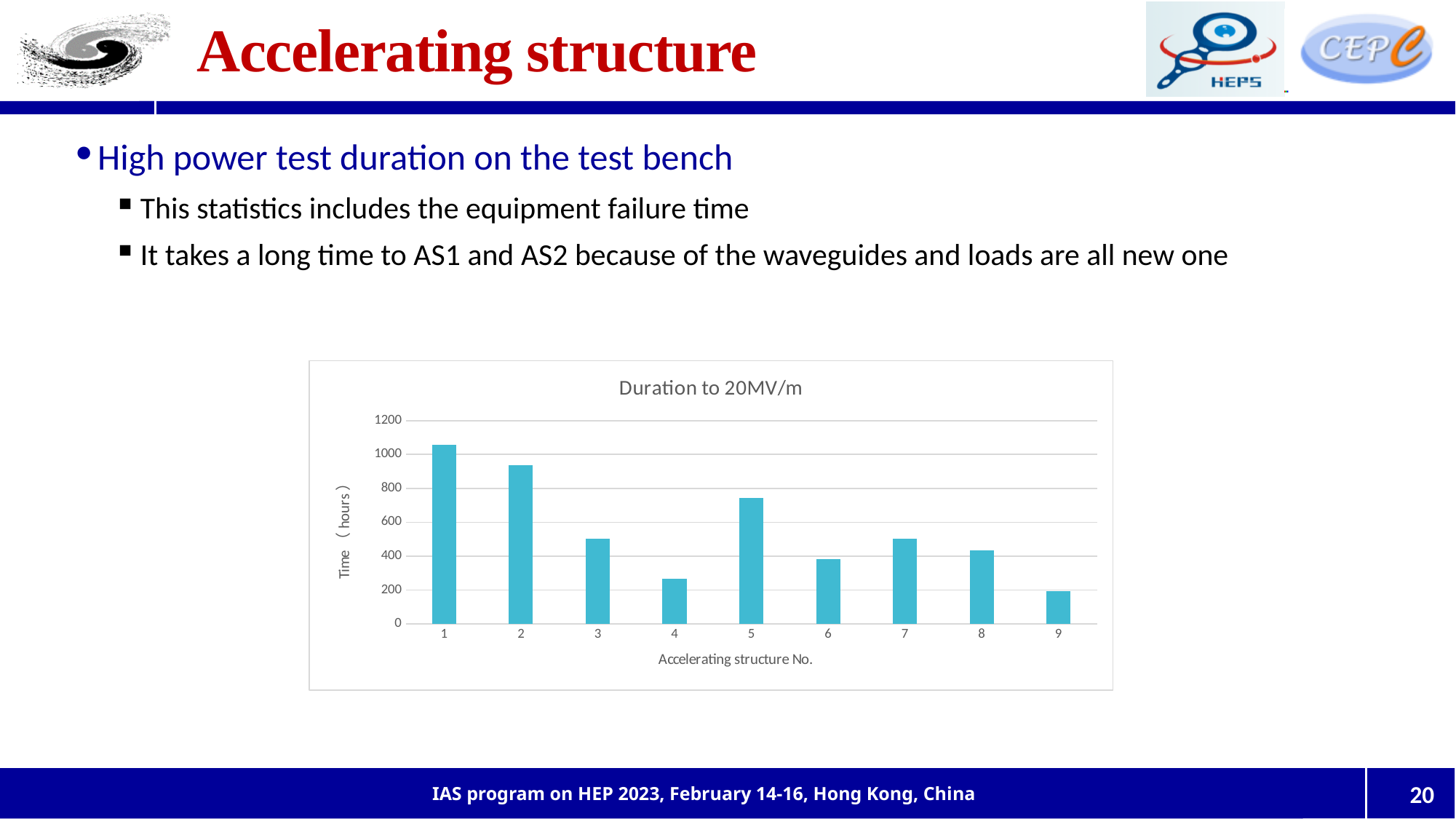
Which has a larger value, accelerating structure 5 or accelerating structure 6? 5 How many accelerating structures are plotted in the chart? 9 Is the value for accelerating structure 1 greater or less than 1000? greater What is the label of the vertical axis of the chart? Time (hours) Which accelerating structure number has the longest duration? 1 What is the title of the chart? Duration to 20MV/m Is the value for accelerating structure 4 greater or less than 400? less Which accelerating structure number has the shortest duration? 9 Is the value for accelerating structure 5 greater or less than 600? greater What kind of chart is shown on the slide? bar chart